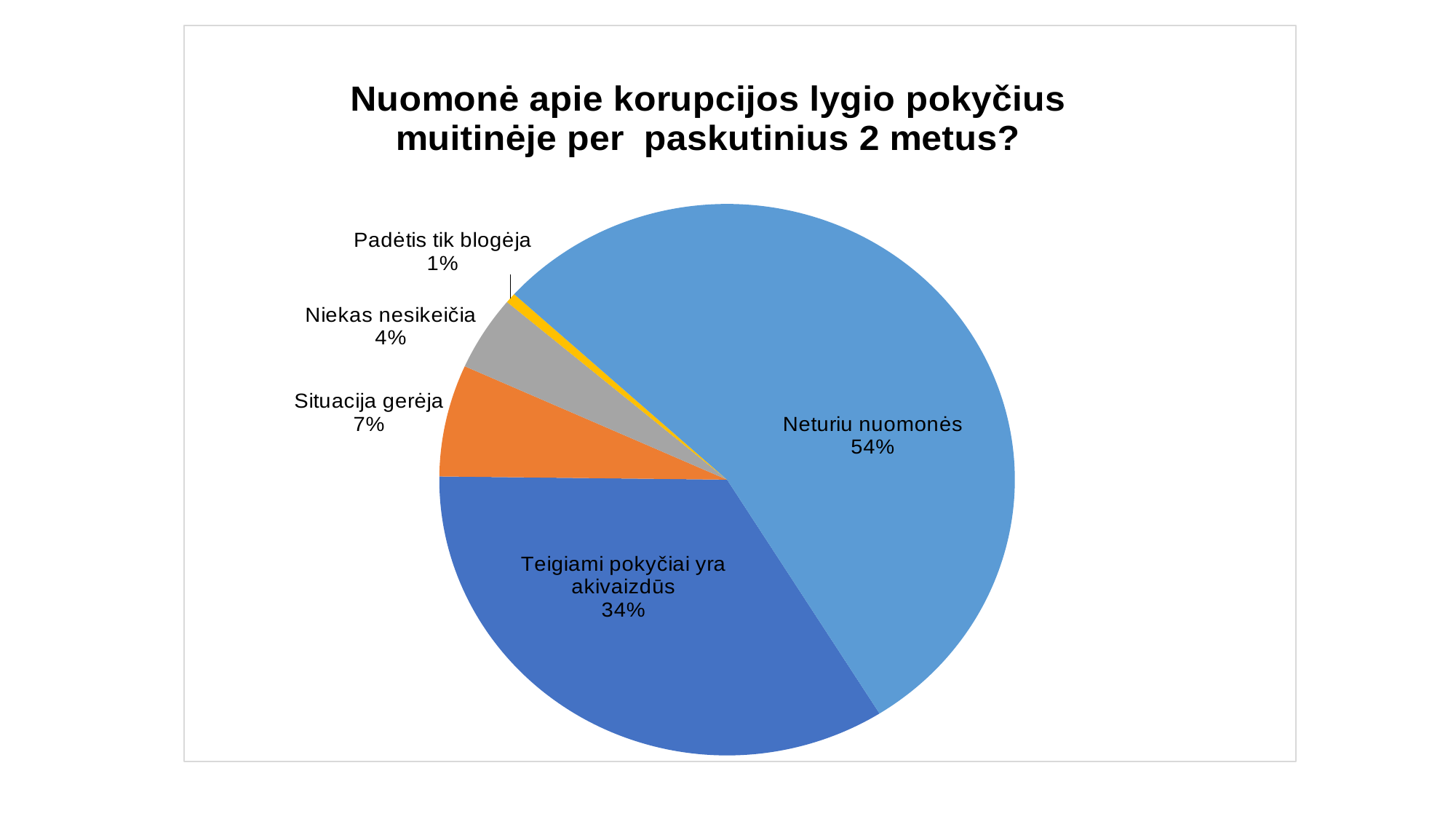
Which is larger, the share for "Situacija gerėja" or the share for "Niekas nesikeičia"? Situacija gerėja What is the difference in percentage points between "Neturiu nuomonės" and "Teigiami pokyčiai yra akivaizdūs"? 20 What share of the pie is labelled "Niekas nesikeičia"? 4% Which slice of the pie is the smallest? Padėtis tik blogėja Which slice of the pie is the largest? Neturiu nuomonės What share of the pie is labelled "Teigiami pokyčiai yra akivaizdūs"? 34% What kind of chart is shown on the slide? pie chart What share of the pie is labelled "Situacija gerėja"? 7% How many slices does the pie chart have? 5 What is the title of the chart? Nuomonė apie korupcijos lygio pokyčius muitinėje per paskutinius 2 metus?